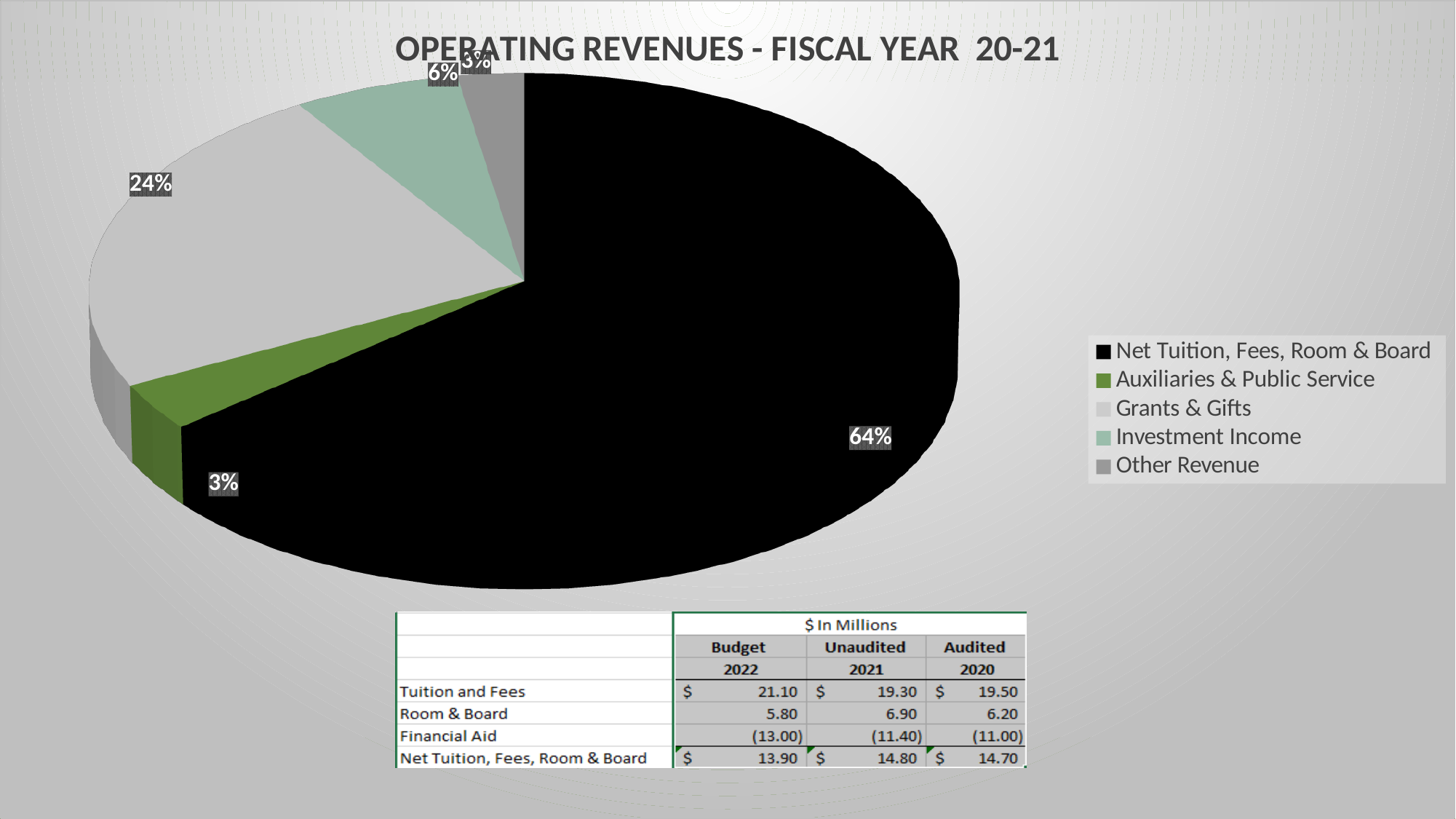
What colour is the Net Tuition, Fees, Room & Board slice? Black What percentage is shown for Auxiliaries & Public Service? 3% How many entries does the legend list? 5 What is the title of the chart? OPERATING REVENUES - FISCAL YEAR 20-21 How many slices does the pie chart have? 5 What percentage of the pie is Grants & Gifts? 24% What share of operating revenues does Net Tuition, Fees, Room & Board represent? 64% What is the difference in percentage points between Net Tuition, Fees, Room & Board and Grants & Gifts? 40 percentage points Which category has the largest slice of the pie? Net Tuition, Fees, Room & Board Which is larger, the Grants & Gifts slice or the Investment Income slice? Grants & Gifts What percentage is shown for Investment Income? 6% What kind of chart is shown on the slide? Pie chart